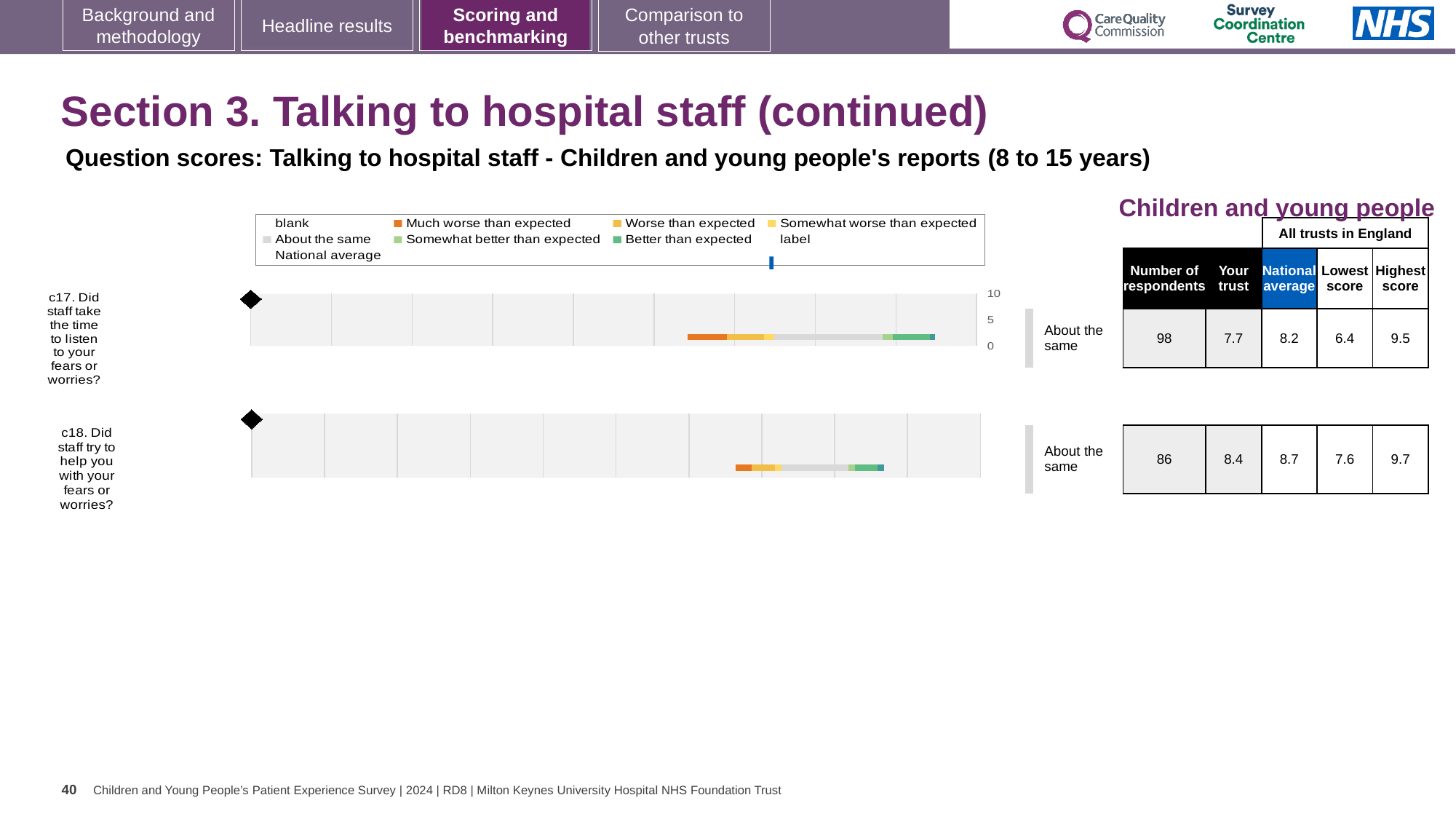
For question c17, what is the difference between the national average and the 'Your trust' score? 0.5 For question c18, what is the difference between the highest score and the lowest score among all trusts in England? 2.1 What benchmarking category is shown for question c17? About the same What is the national average score for question c18 (Did staff try to help you with your fears or worries?)? 8.7 Which question has the higher 'Your trust' score, c17 or c18? c18 Which question had more respondents, c17 or c18? c17 What is the highest score among all trusts in England for question c18? 9.7 What kind of chart is used to show the benchmarking for each question? Bar chart How many survey questions are plotted in the charts on this slide? 2 What is the lowest score among all trusts in England for question c17? 6.4 What is the 'Your trust' score for question c17 (Did staff take the time to listen to your fears or worries?)? 7.7 How many respondents answered question c17? 98